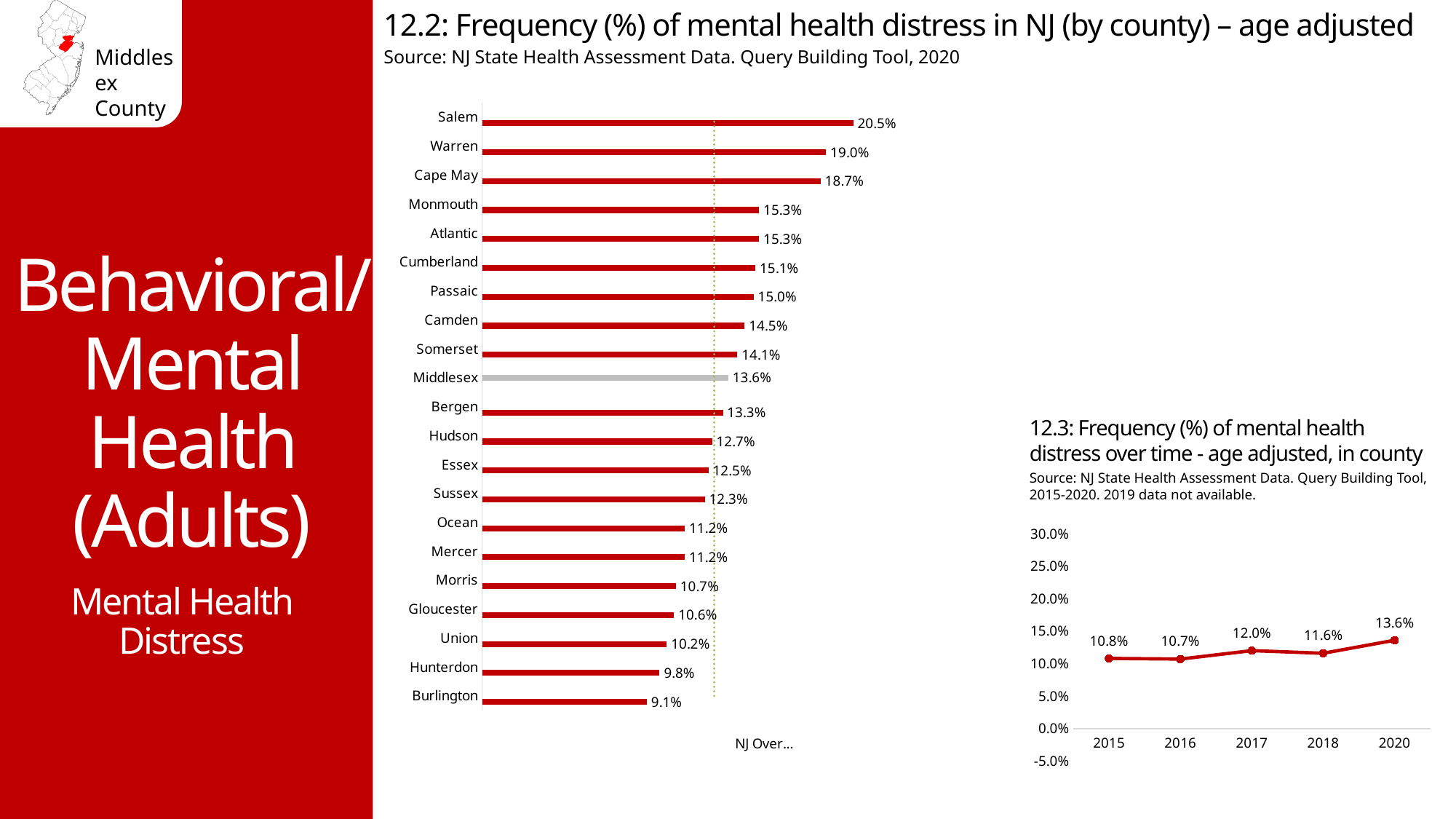
In chart 12.2 (by county), what is the difference between the values for Salem and Burlington? 11.4% In chart 12.2 (by county), which county has the highest frequency of mental health distress? Salem What type of chart is chart 12.2 (frequency of mental health distress by county)? Bar chart In chart 12.2 (by county), what is the value for Hunterdon? 9.8% In chart 12.3 (mental health distress over time), what is the value for 2017? 12.0% In chart 12.3 (over time), which year has the highest value? 2020 In chart 12.2 (by county), which county has the lowest frequency of mental health distress? Burlington In chart 12.3 (over time), what is the difference between the 2020 and 2015 values? 2.8% In chart 12.2 (frequency of mental health distress by county), what is the value for Middlesex? 13.6% What type of chart is chart 12.3 (mental health distress over time)? Line chart In chart 12.2 (by county), which has a higher value, Warren or Cape May? Warren How many counties are shown in chart 12.2 (by county)? 21